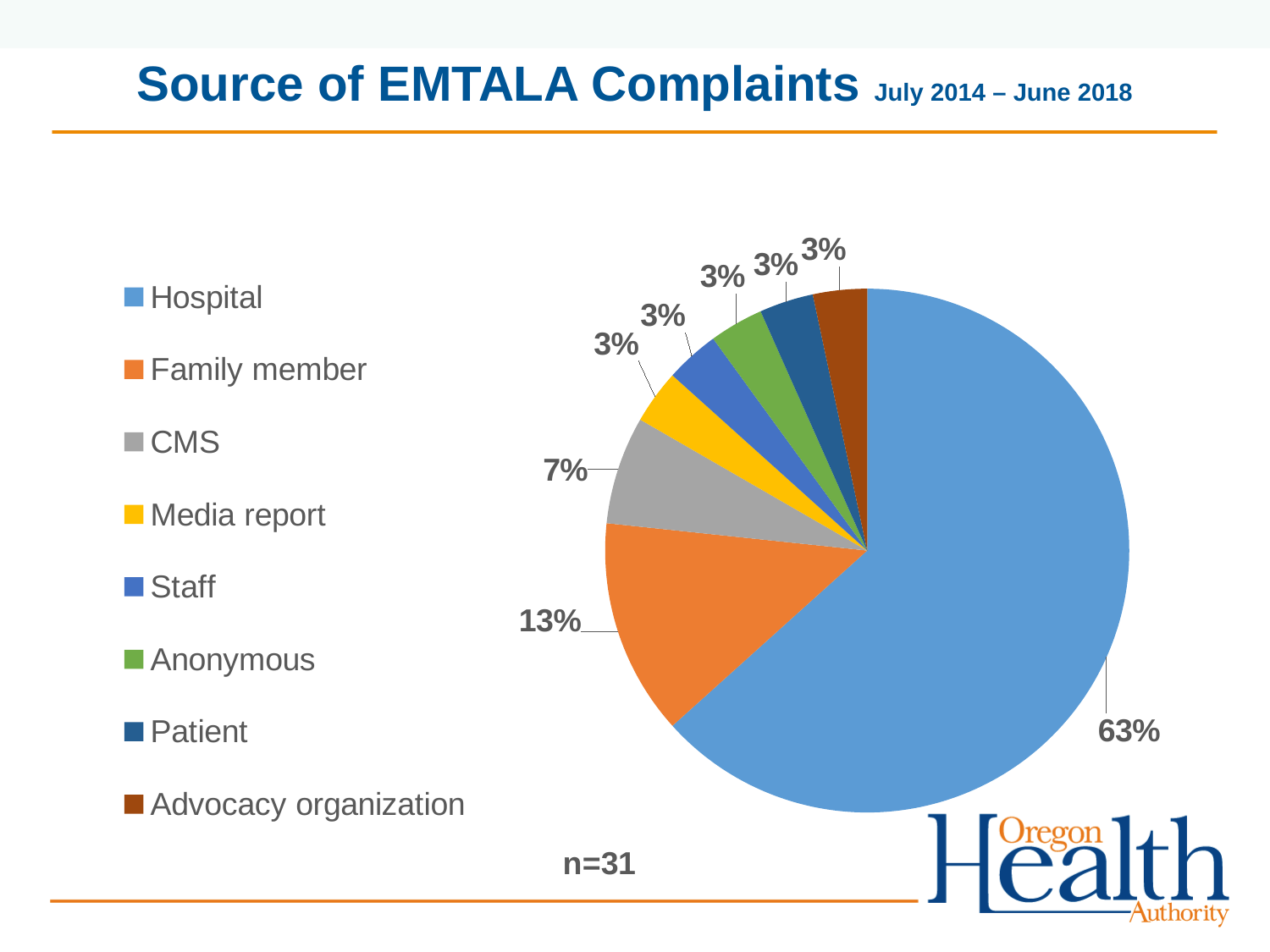
What is the total number of complaints (n) shown on the slide? n=31 What kind of chart is shown on the slide? Pie chart How many sources are listed in the legend? 8 Which source accounts for the largest share of complaints? Hospital What is the difference in percentage points between the Hospital and Family member shares? 50 percentage points What share of EMTALA complaints came from Hospital? 63% What share of EMTALA complaints came from CMS? 7% What is the difference in percentage points between the Family member and CMS shares? 6 percentage points What share of EMTALA complaints came from Family member? 13% What time period does the chart title cover? July 2014 – June 2018 Which is larger, the share for Family member or the share for CMS? Family member What share of EMTALA complaints came from Media report? 3%